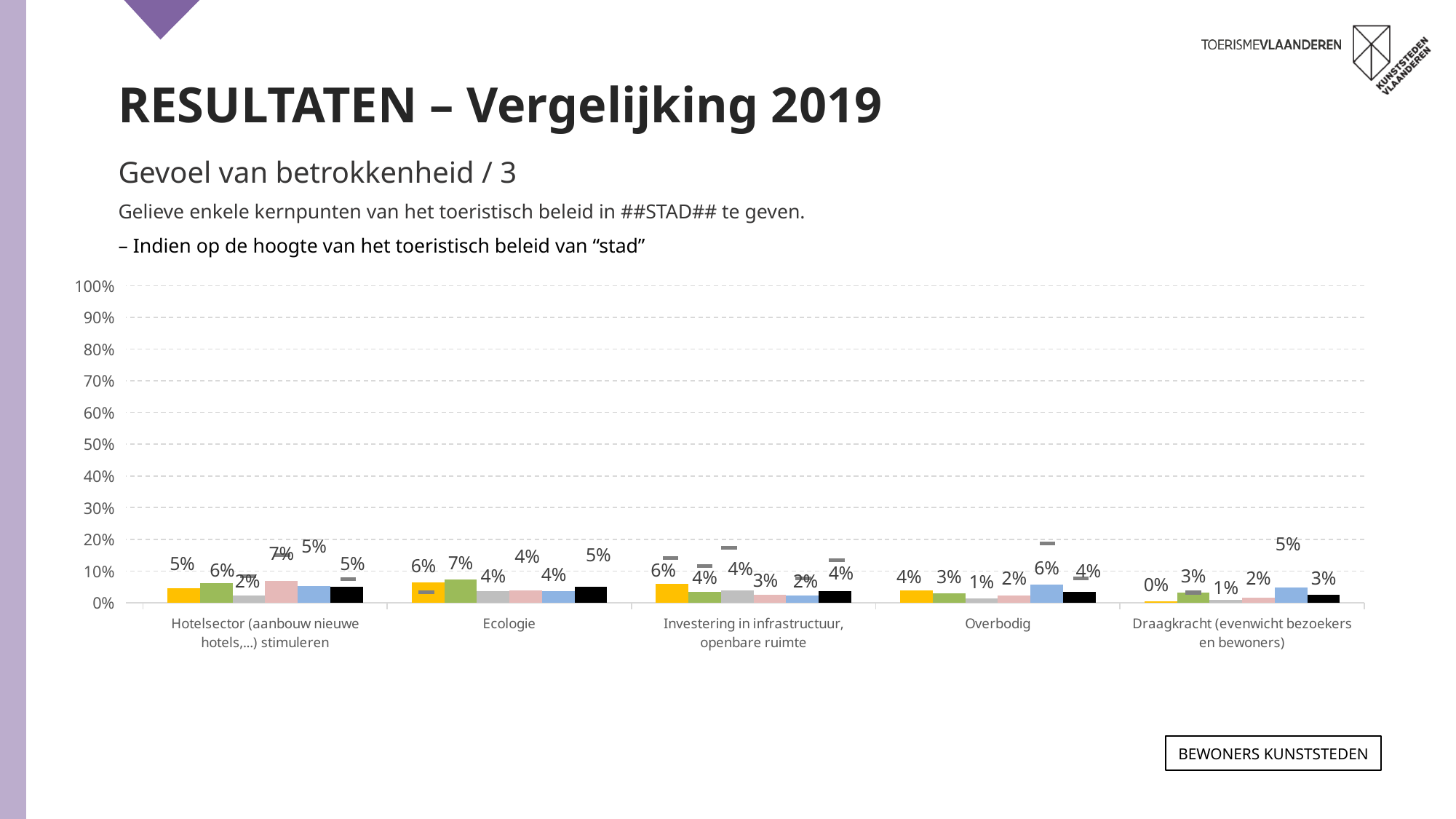
What is the difference between the green bar and the grey bar for Ecologie? 3% What is the value of the yellow bar for Draagkracht (evenwicht bezoekers en bewoners)? 0% What is the value of the pink bar for Hotelsector (aanbouw nieuwe hotels,...) stimuleren? 7% Which bar has the highest value in the Hotelsector (aanbouw nieuwe hotels,...) stimuleren category? the pink bar (7%) What is the value of the black bar for Investering in infrastructuur, openbare ruimte? 4% What is the value of the yellow bar for Ecologie? 6% Which bar has the lowest value in the Overbodig category? the grey bar (1%) Is the value of the green bar for Ecologie greater or less than 10%? less How many categories are shown along the x axis of the chart? 5 Which is larger for Overbodig: the blue bar or the yellow bar? the blue bar What is the value of the blue bar for Overbodig? 6% What kind of chart is shown on the slide? bar chart